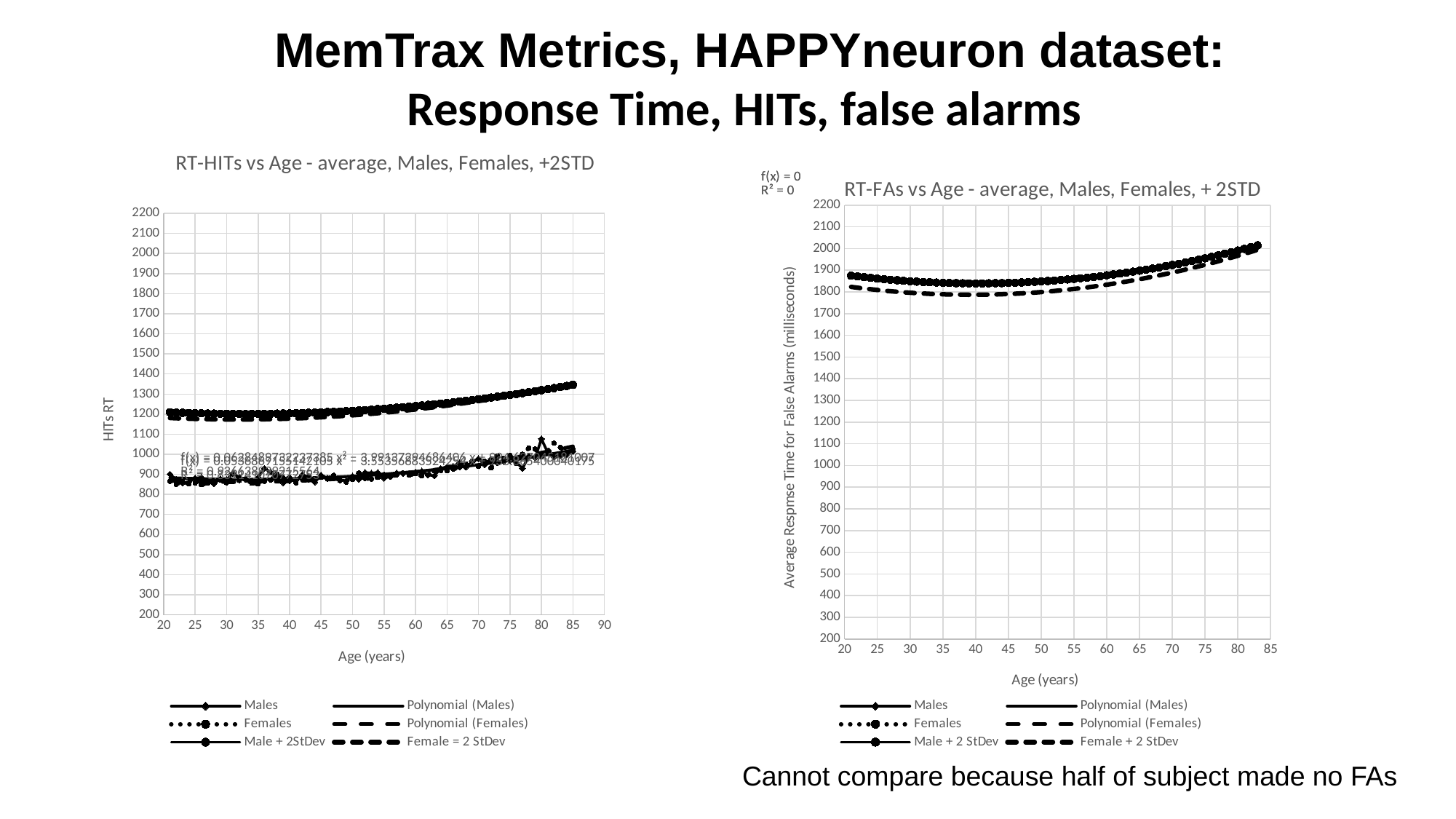
What is the y-axis title of the left chart 'RT-HITs vs Age'? HITs RT In the left chart 'RT-HITs vs Age', is the value of the Males series at age 20 greater or less than 1000? less In the right chart 'RT-FAs vs Age', is the value of the Male + 2 StDev line at age 83 greater or less than 1900? greater In the right chart 'RT-FAs vs Age', which is larger at age 40: the Male + 2 StDev line or the Female + 2 StDev line? Male + 2 StDev In the right chart 'RT-FAs vs Age', is the value of the Female + 2 StDev line at age 40 greater or less than 1900? less What is the x-axis title of the right chart 'RT-FAs vs Age'? Age (years) In the left chart 'RT-HITs vs Age', which is larger at age 85: the Male + 2StDev line or the Males series? Male + 2StDev How many series does the legend of the left chart 'RT-HITs vs Age' list? 6 How many series does the legend of the right chart 'RT-FAs vs Age' list? 6 In the left chart 'RT-HITs vs Age', does the Male + 2StDev line rise or fall as age increases from 20 to 85? rise What kind of chart is the left chart, 'RT-HITs vs Age - average, Males, Females, +2STD'? line chart